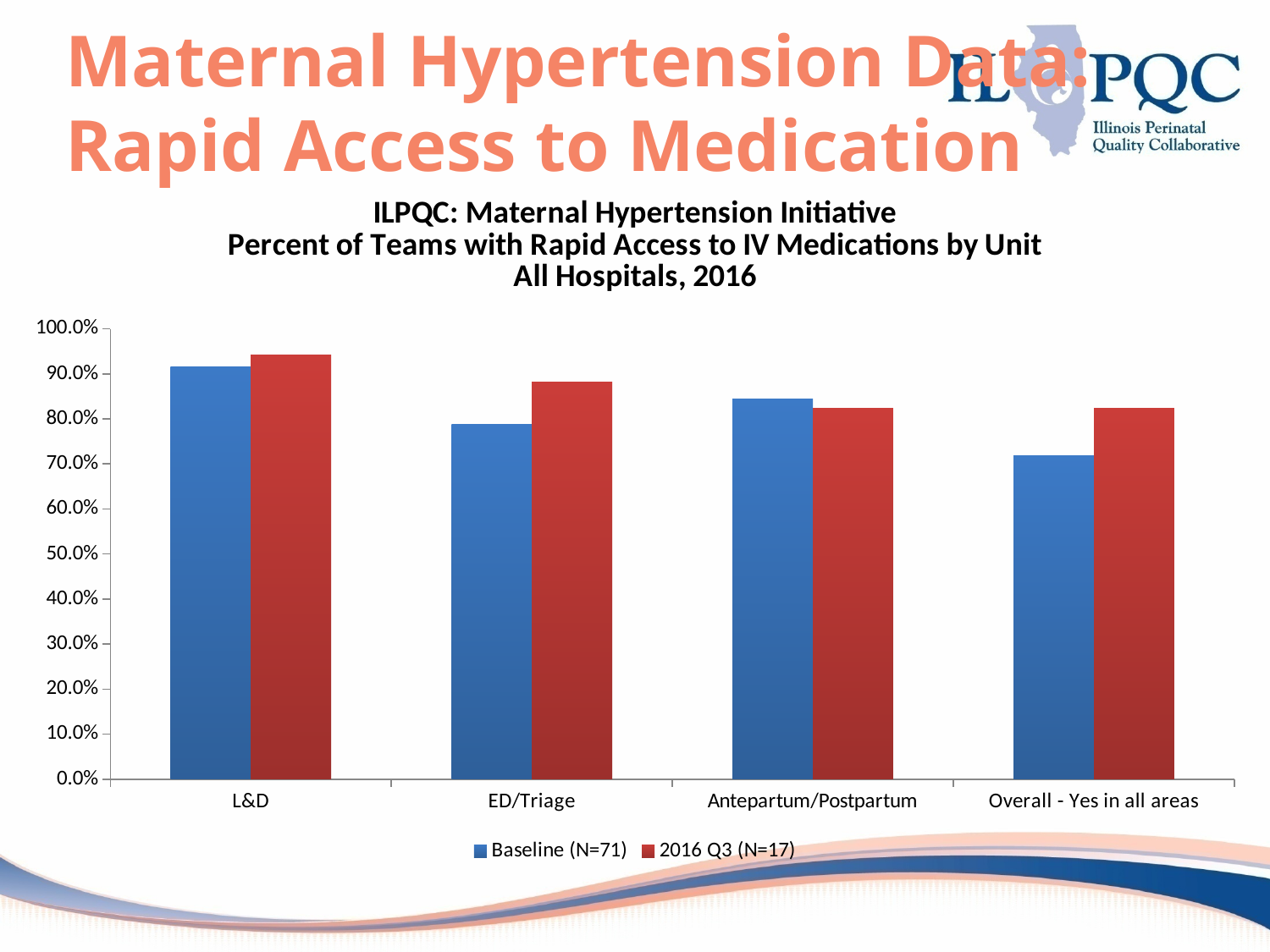
What are the two legend entries of the chart? Baseline (N=71) and 2016 Q3 (N=17) Is the Baseline (N=71) value for L&D greater or less than 80.0%? greater For Overall - Yes in all areas, which is larger: Baseline (N=71) or 2016 Q3 (N=17)? 2016 Q3 (N=17) Is the 2016 Q3 (N=17) value for ED/Triage greater or less than 80.0%? greater Which unit has the highest 2016 Q3 (N=17) value? L&D How many series does the legend list? 2 For ED/Triage, which is larger: Baseline (N=71) or 2016 Q3 (N=17)? 2016 Q3 (N=17) Is the Baseline (N=71) value for Overall - Yes in all areas greater or less than 80.0%? less Which unit has the highest Baseline (N=71) value? L&D Which unit has the lowest Baseline (N=71) value? Overall - Yes in all areas How many unit categories are shown on the x axis? 4 What kind of chart is shown on the slide? Bar chart